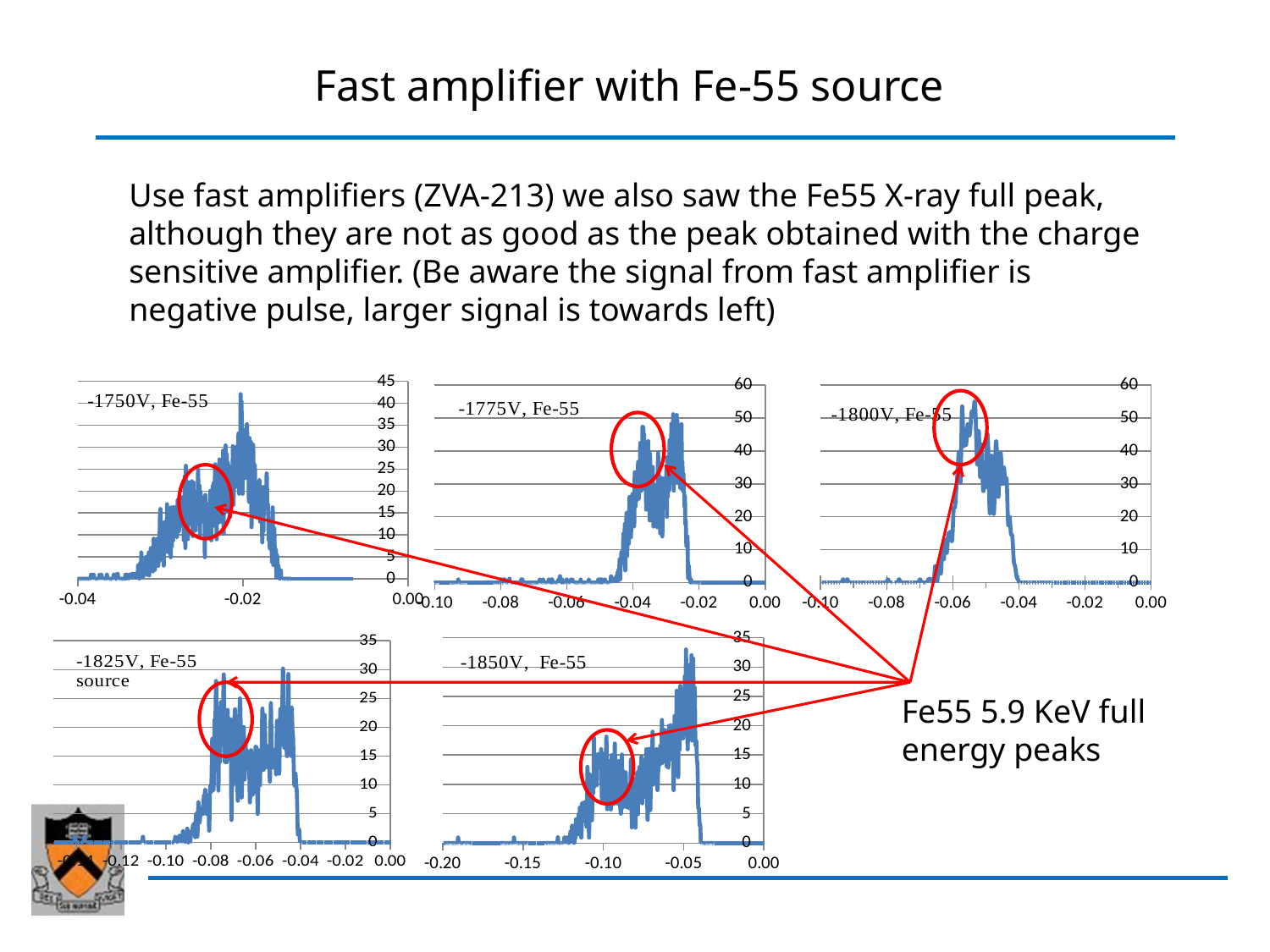
In the -1850V, Fe-55 chart, is the value at x = -0.15 greater or less than 5? less In the -1775V, Fe-55 chart, is the value at x = -0.08 greater or less than 10? less In the -1825V, Fe-55 source chart, is the highest peak value greater or less than 25? greater What is the maximum value shown on the y axis of the -1750V, Fe-55 chart? 45 How many charts are shown on the slide? 5 What kind of chart is the -1750V, Fe-55 chart? line chart What is the maximum value shown on the y axis of the -1800V, Fe-55 chart? 60